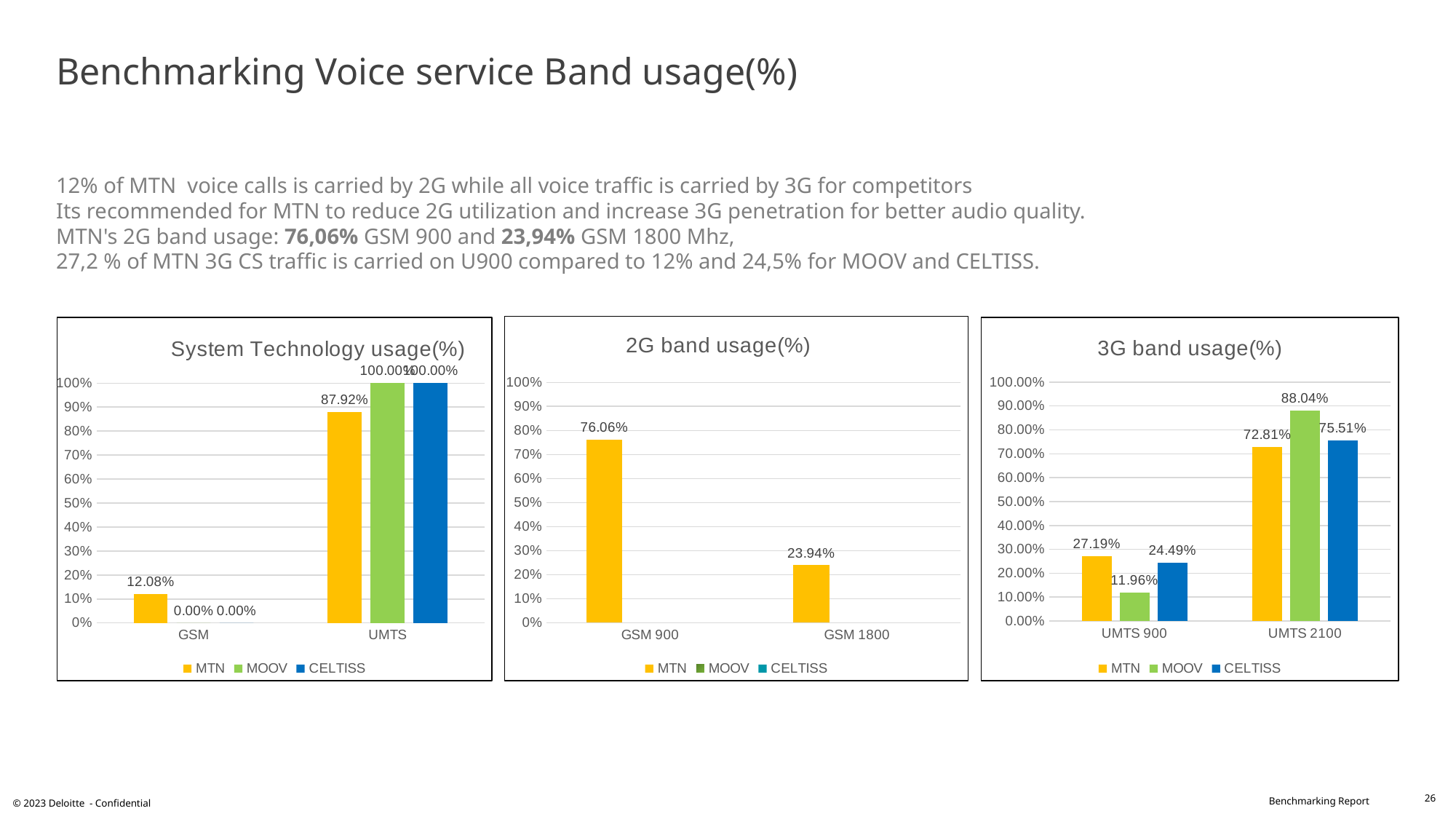
In the '3G band usage(%)' chart, what is the value for CELTISS at UMTS 900? 24.49% In the '2G band usage(%)' chart, what is the difference between the GSM 900 and GSM 1800 values for MTN? 52.12% In the 'System Technology usage(%)' chart, what is the value for MTN in the UMTS category? 87.92% What kind of chart is the '2G band usage(%)' chart? Bar chart In the '3G band usage(%)' chart, which is larger at UMTS 2100: MTN or CELTISS? CELTISS In the 'System Technology usage(%)' chart, what is the value for MTN in the GSM category? 12.08% In the '2G band usage(%)' chart, what is the value for MTN at GSM 900? 76.06% In the 'System Technology usage(%)' chart, what is the value for MOOV in the GSM category? 0.00% How many series does the legend of the '3G band usage(%)' chart list? 3 In the '3G band usage(%)' chart, which operator has the lowest value at UMTS 900? MOOV In the '2G band usage(%)' chart, which category has the lower value for MTN? GSM 1800 In the '3G band usage(%)' chart, which operator has the highest value at UMTS 2100? MOOV